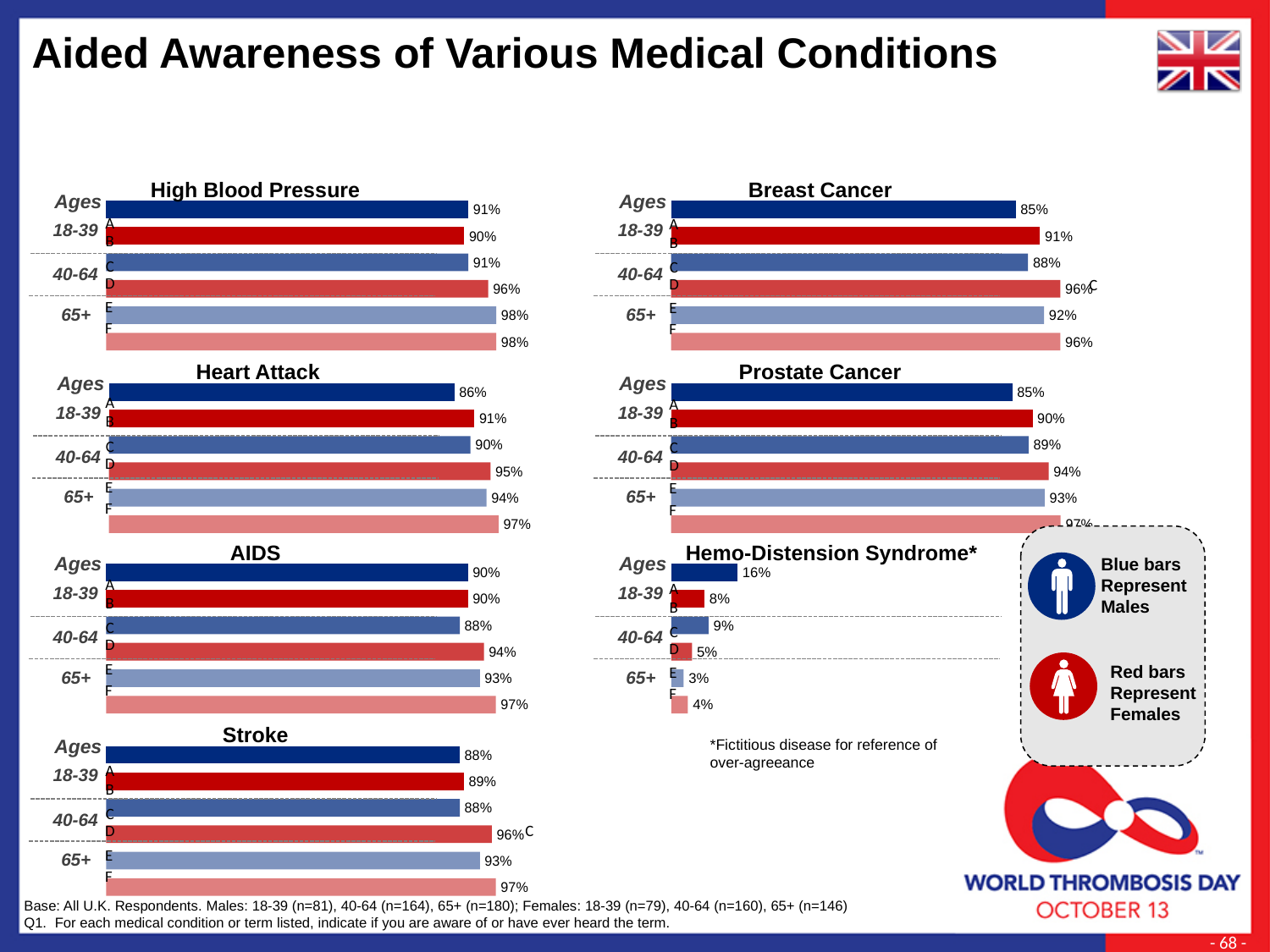
According to the legend on the slide, what do the blue bars represent? Males In the High Blood Pressure chart, what is the value for males aged 65+? 98% In the Stroke chart, what is the difference between females aged 40-64 and males aged 40-64? 8% In the Heart Attack chart, what is the difference between females aged 18-39 and males aged 18-39? 5% In the Hemo-Distension Syndrome* chart, which group has the lowest value? Males 65+ In the Hemo-Distension Syndrome* chart, what is the value for males aged 18-39? 16% In the Heart Attack chart, what is the value for females aged 40-64? 95% In the AIDS chart, which is larger: the value for females aged 65+ or males aged 65+? Females 65+ What type of chart is used for the Stroke data? Bar chart In the Hemo-Distension Syndrome* chart, do the values for males rise or fall as age increases from 18-39 to 65+? Fall In the Breast Cancer chart, which group has the lowest value? Males 18-39 How many bars does the Prostate Cancer chart show? 6